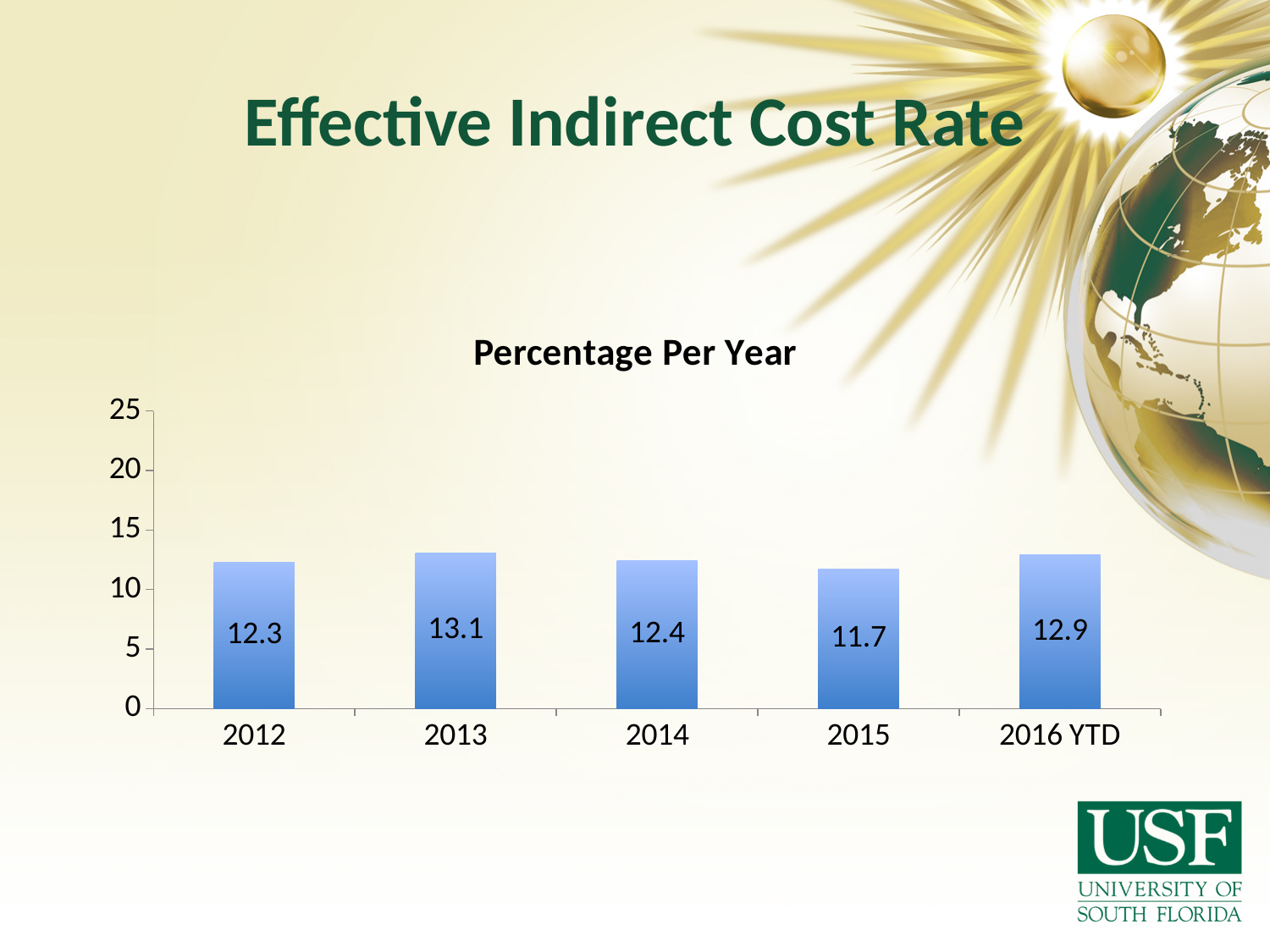
What is the value for 2016 YTD? 12.9 What is the value for 2012? 12.3 What is the title of the chart? Percentage Per Year What is the difference between the values for 2013 and 2015? 1.4 What kind of chart is shown? bar chart How many years are shown on the x axis? 5 Which year has the highest value? 2013 Is the value for 2013 greater or less than 15? less What is the value for 2015? 11.7 Does the value rise or fall from 2014 to 2015? fall Which is larger, the value for 2014 or the value for 2016 YTD? 2016 YTD Which year has the lowest value? 2015